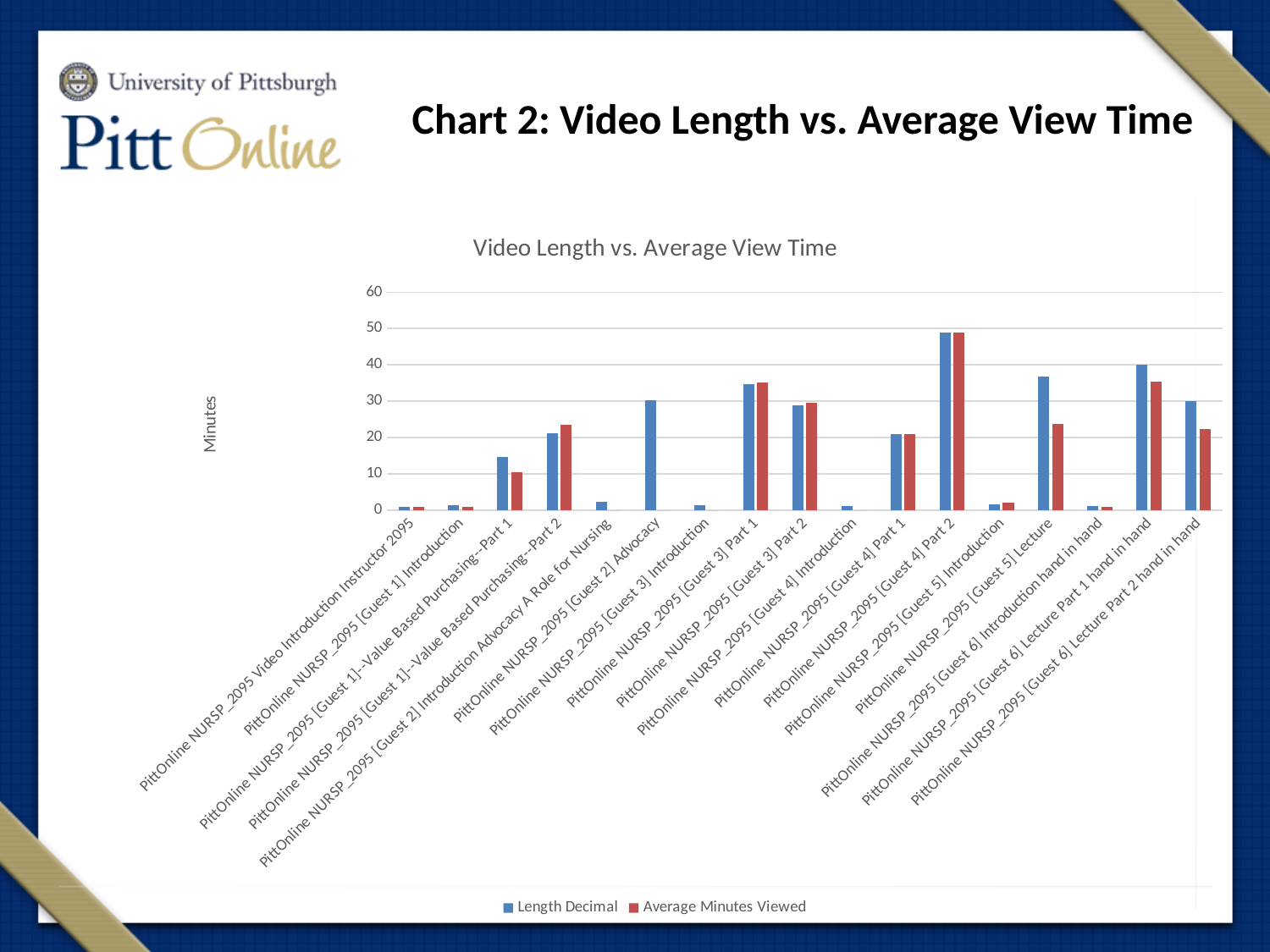
Is the Average Minutes Viewed value for PittOnline NURSP_2095 [Guest 5] Lecture greater or less than 30? less What kind of chart is shown on the slide? Bar chart What is the label on the vertical axis? Minutes Which video has the highest Length Decimal value? PittOnline NURSP_2095 [Guest 4] Part 2 How many series does the legend list? 2 For PittOnline NURSP_2095 [Guest 5] Lecture, which is larger: Length Decimal or Average Minutes Viewed? Length Decimal For PittOnline NURSP_2095 [Guest 6] Lecture Part 2 hand in hand, which is larger: Length Decimal or Average Minutes Viewed? Length Decimal What are the two series named in the legend? Length Decimal and Average Minutes Viewed Is the Length Decimal value for PittOnline NURSP_2095 [Guest 1]--Value Based Purchasing--Part 1 greater or less than 10? greater Is the Length Decimal value for PittOnline NURSP_2095 [Guest 2] Advocacy greater or less than 20? greater How many video categories are plotted along the x axis? 17 Which video has the highest Average Minutes Viewed value? PittOnline NURSP_2095 [Guest 4] Part 2